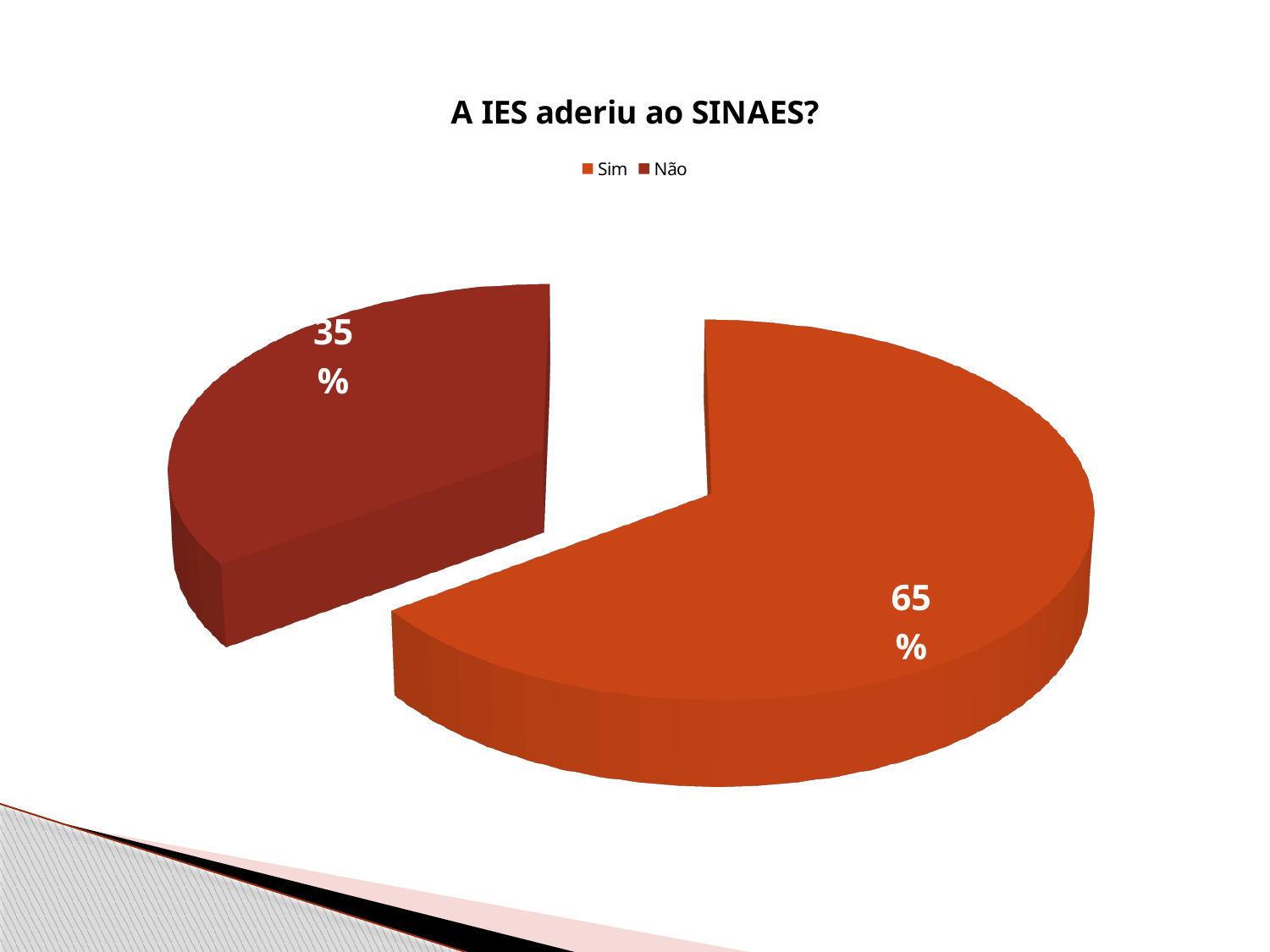
How many categories does the pie chart show? 2 What is the value printed on the dark red slice? 35% What is the value printed on the orange slice? 65% Which is larger, the "Sim" slice or the "Não" slice? Sim Which category has the largest slice of the pie? Sim How many entries does the legend list? 2 What share of the pie does "Sim" represent? 65% Which category has the smallest slice of the pie? Não What is the title of the chart? A IES aderiu ao SINAES? What is the difference in percentage points between the "Sim" and "Não" slices? 30 What share of the pie does "Não" represent? 35% What kind of chart is shown on the slide? pie chart